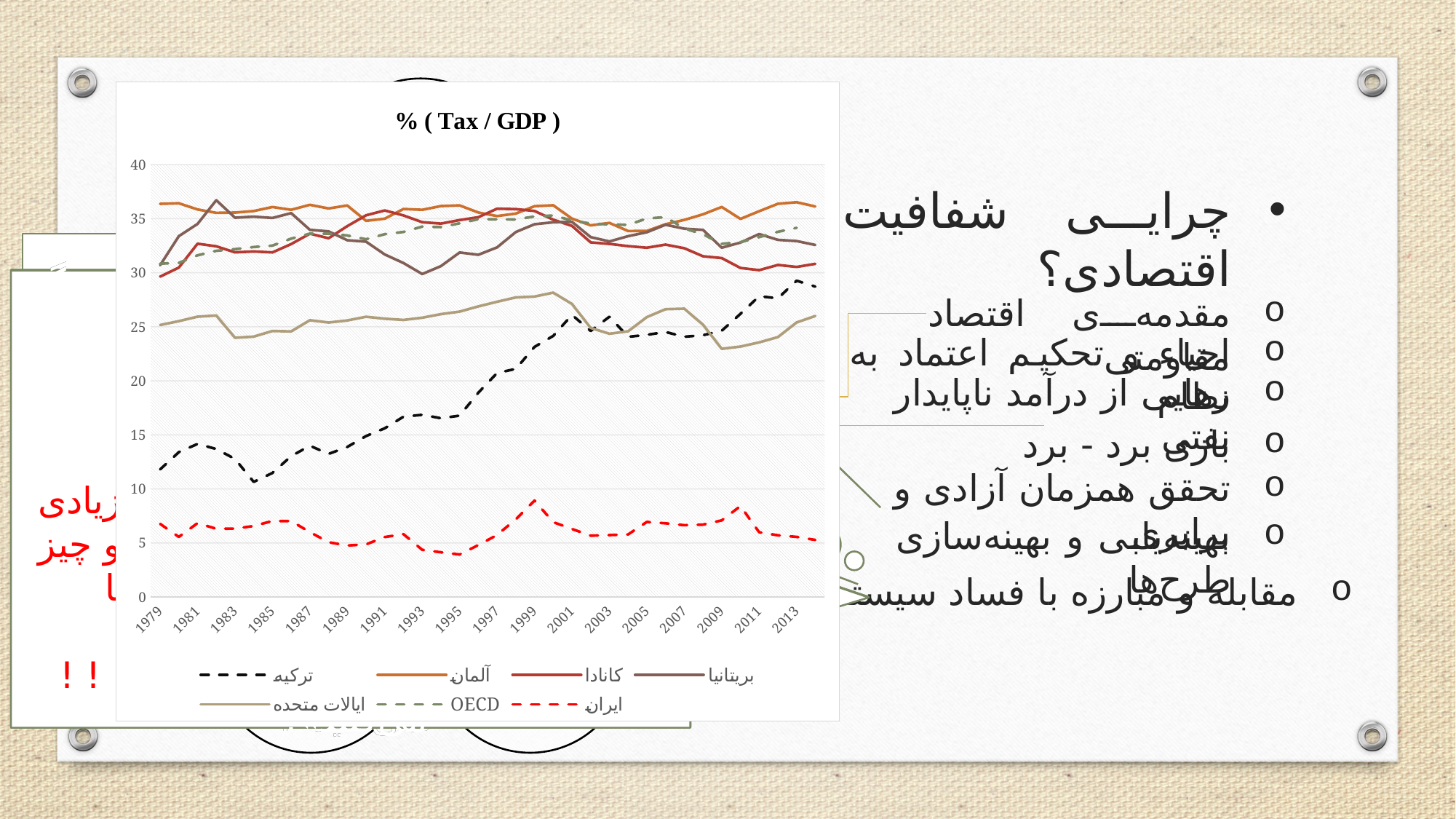
Which series is the lowest across the whole period in the "% ( Tax / GDP )" chart? ایران How many series does the legend of the "% ( Tax / GDP )" chart list? 7 Does the value for ترکیه generally rise or fall from 1979 to 2013? rise Is the value for ترکیه in 1979 greater or less than 10? greater In 2013, which is larger: the value for آلمان or the value for کانادا? آلمان Is the value for ایران in 1999 greater or less than 10? less Is the value for ایالات متحده in 2009 greater or less than 25? less In 1979, which is larger: the value for ایالات متحده or the value for ترکیه? ایالات متحده What is the title of the chart? % ( Tax / GDP ) Which series is drawn as a red dashed line in the chart? ایران What kind of chart is shown on the slide? line chart